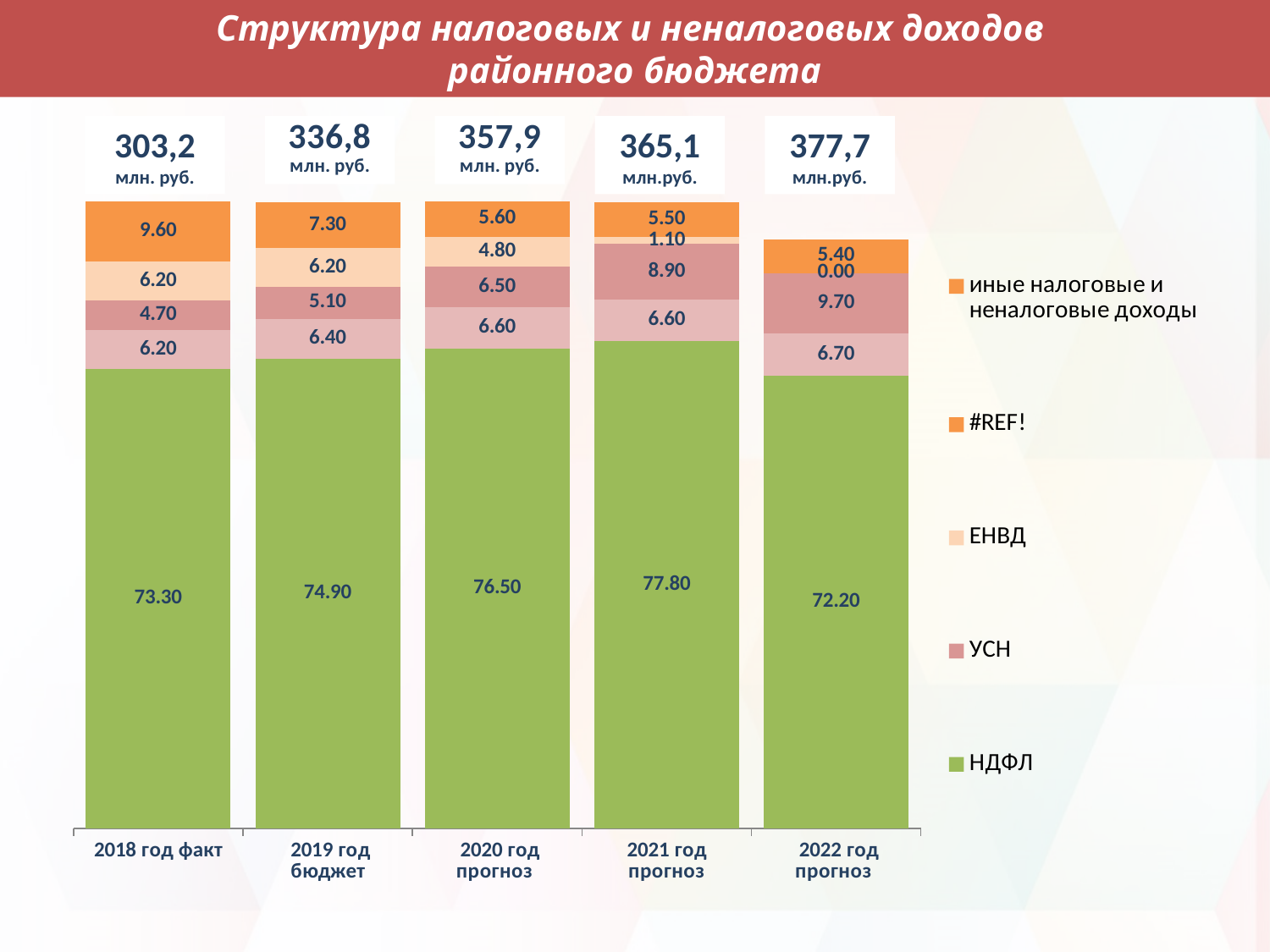
What is the value of НДФЛ for 2021 год прогноз? 77.80 Which is larger, the total amount for 2019 год бюджет or for 2022 год прогноз? 2022 год прогноз What type of chart is shown on the slide? stacked bar chart What total amount is shown above the bar for 2020 год прогноз? 357,9 млн. руб. In which year is the НДФЛ value the highest? 2021 год прогноз What is the value of ЕНВД for 2022 год прогноз? 0.00 What is the value of НДФЛ for 2018 год факт? 73.30 What is the difference between the НДФЛ values for 2021 год прогноз and 2018 год факт? 4.50 How many series does the legend list? 5 In which year is the НДФЛ value the lowest? 2022 год прогноз How many categories (years) are shown on the x axis? 5 Do the total amounts shown above the bars rise or fall from 2018 to 2022? rise